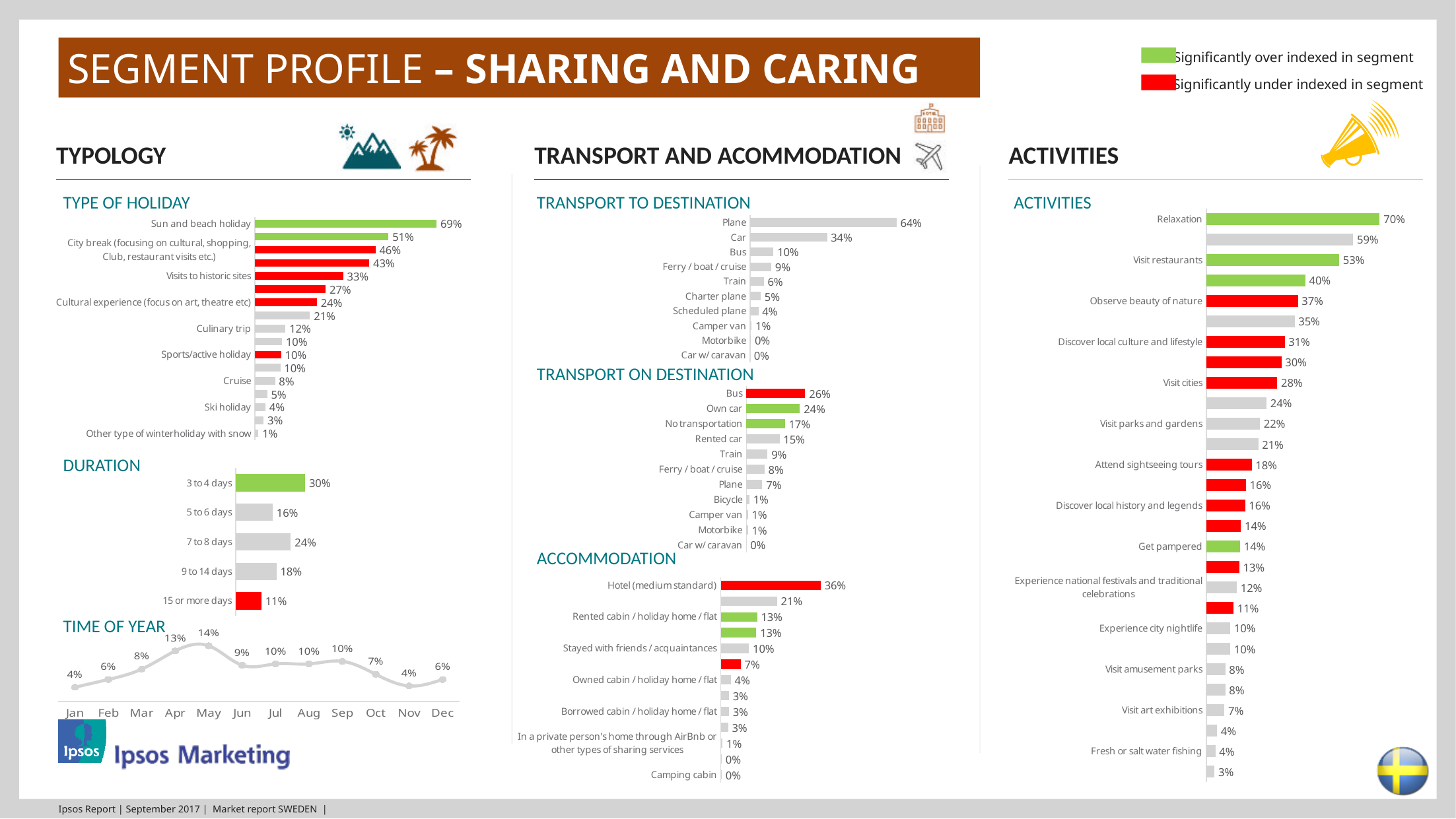
In the Transport on Destination chart, which category has the highest value? Bus In the Type of Holiday chart, what is the value for Visits to historic sites? 33% In the Transport to Destination chart, what is the value for Car? 34% In the Transport on Destination chart, which is larger, Own car or Rented car? Own car In the Duration chart, what is the difference between 7 to 8 days and 5 to 6 days? 8% In the Accommodation chart, what is the value for Hotel (medium standard)? 36% In the Duration chart, which duration has the lowest value? 15 or more days In the Time of Year chart, which month has the highest value? May In the Time of Year chart, what is the value for Sep? 10% What kind of chart is the Time of Year chart? Line chart In the Activities chart, what is the value for Relaxation? 70% In the Duration chart, what is the value for 3 to 4 days? 30%